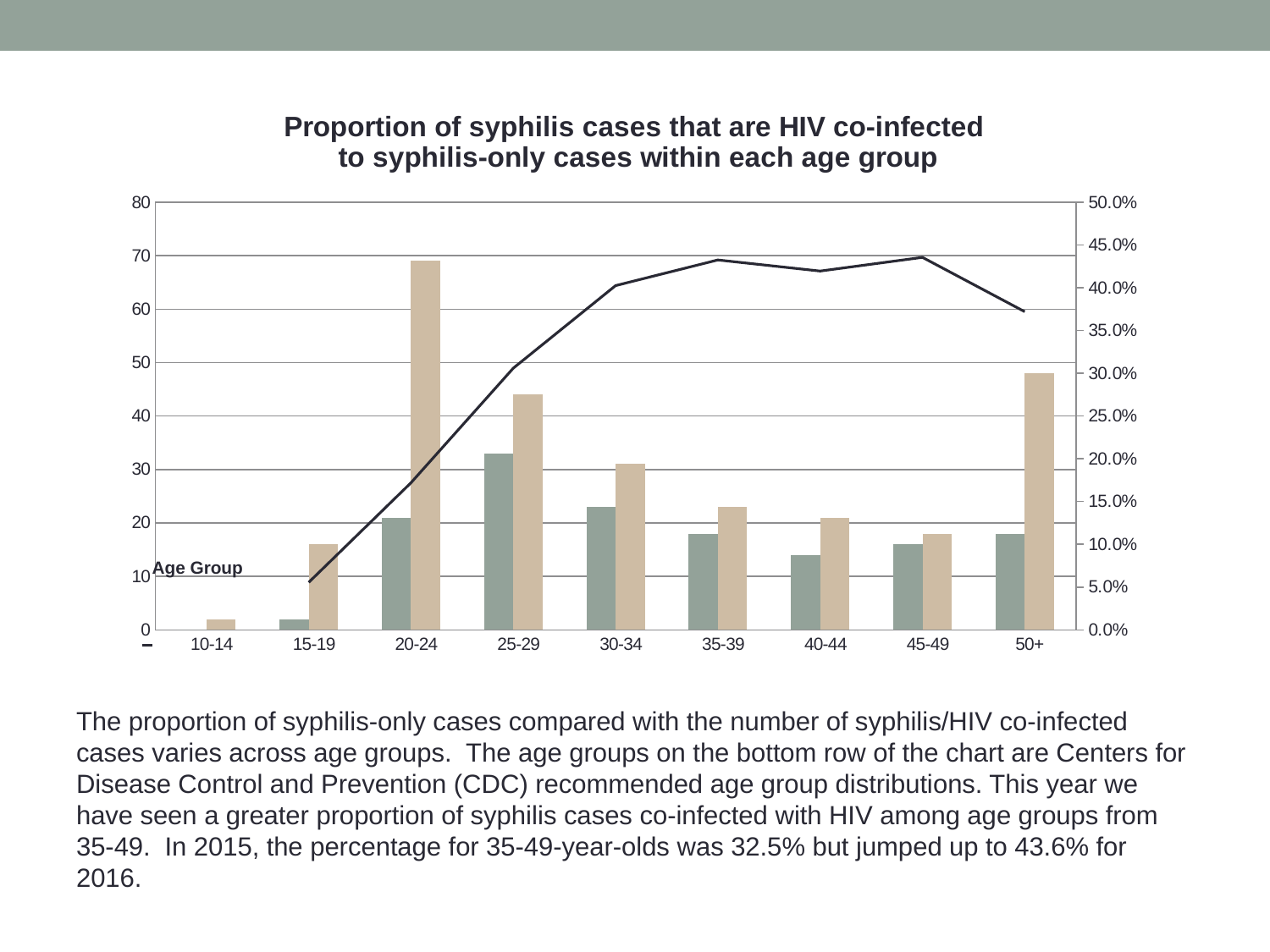
Which age group has the tallest tan bar? 20-24 What is the title of the chart? Proportion of syphilis cases that are HIV co-infected to syphilis-only cases within each age group Is the tan bar for the 50+ age group greater or less than 40 on the left axis? greater Is the green bar for the 25-29 age group greater or less than 30 on the left axis? greater Is the line value for the 35-39 age group greater or less than 40.0% on the right axis? greater Which age group has the shortest tan bar? 10-14 For the 20-24 age group, which bar is taller, the tan bar or the green bar? the tan bar What kind of chart is shown on the slide? bar chart with a line overlay Does the line rise or fall from the 15-19 age group to the 35-39 age group? rises Which age group has the tallest green bar? 25-29 How many age groups are shown on the x axis? 9